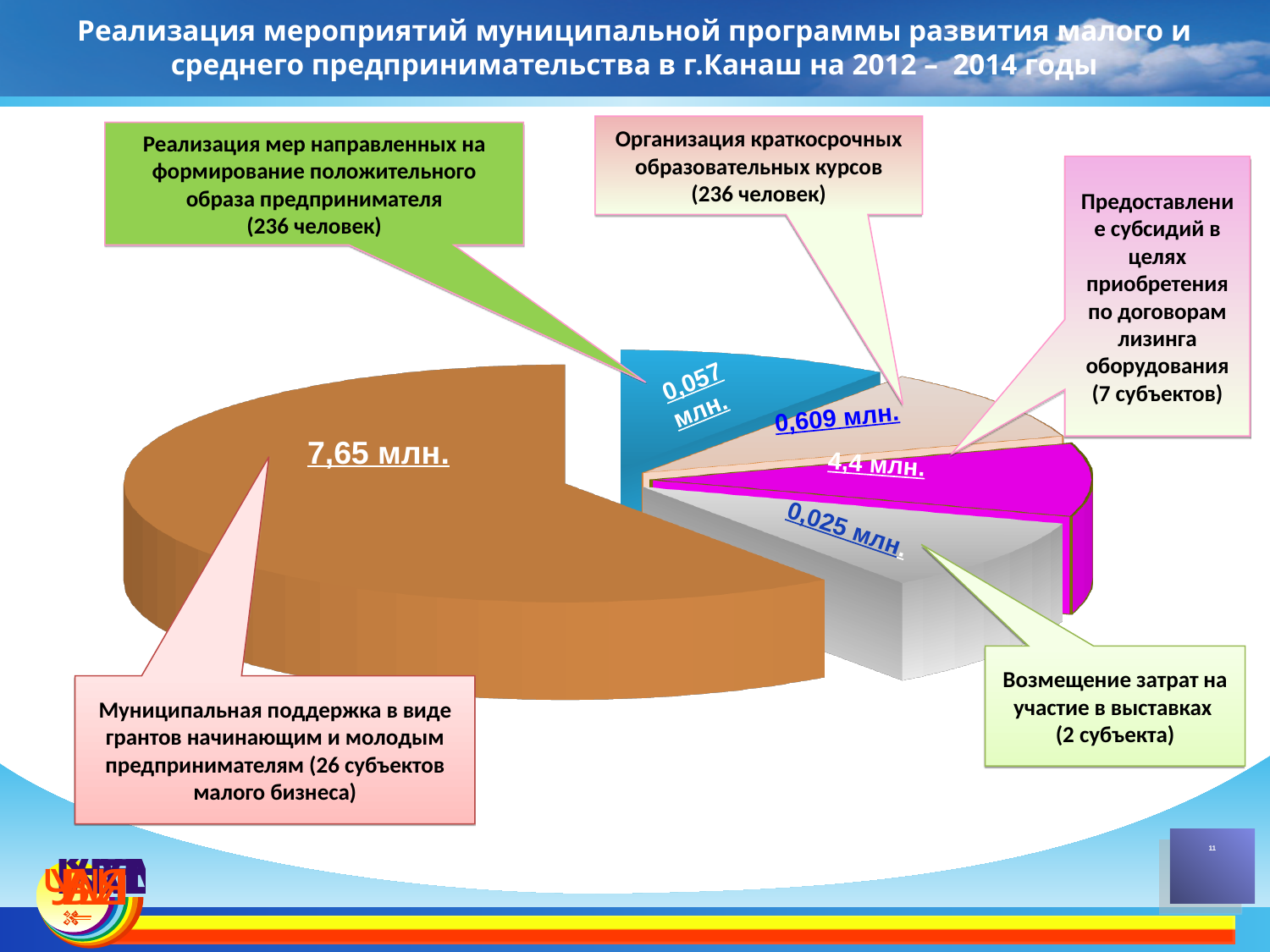
What value is labelled on the slice for 'Организация краткосрочных образовательных курсов'? 0,609 млн. Which slice of the pie chart has the smallest value? 0,025 млн. (Возмещение затрат на участие в выставках) Which slice of the pie chart has the largest value? 7,65 млн. (Муниципальная поддержка в виде грантов начинающим и молодым предпринимателям) What is the difference between the 7,65 млн. slice and the 4,4 млн. slice? 3,25 млн. What value is labelled on the largest (brown) slice of the pie chart? 7,65 млн. According to the callout, how many subjects received subsidies for purchasing equipment under leasing agreements? 7 субъектов What value is labelled on the blue slice, which the callout 'Реализация мер направленных на формирование положительного образа предпринимателя' points to? 0,057 млн. Which is larger: the value for 'Организация краткосрочных образовательных курсов' or the value for 'Реализация мер направленных на формирование положительного образа предпринимателя'? Организация краткосрочных образовательных курсов (0,609 млн.) How many slices does the pie chart have? 5 What value is labelled on the grey slice for 'Возмещение затрат на участие в выставках'? 0,025 млн. What kind of chart is shown on the slide? pie chart What value is labelled on the magenta slice, which the callout 'Предоставление субсидий в целях приобретения по договорам лизинга оборудования' points to? 4,4 млн.